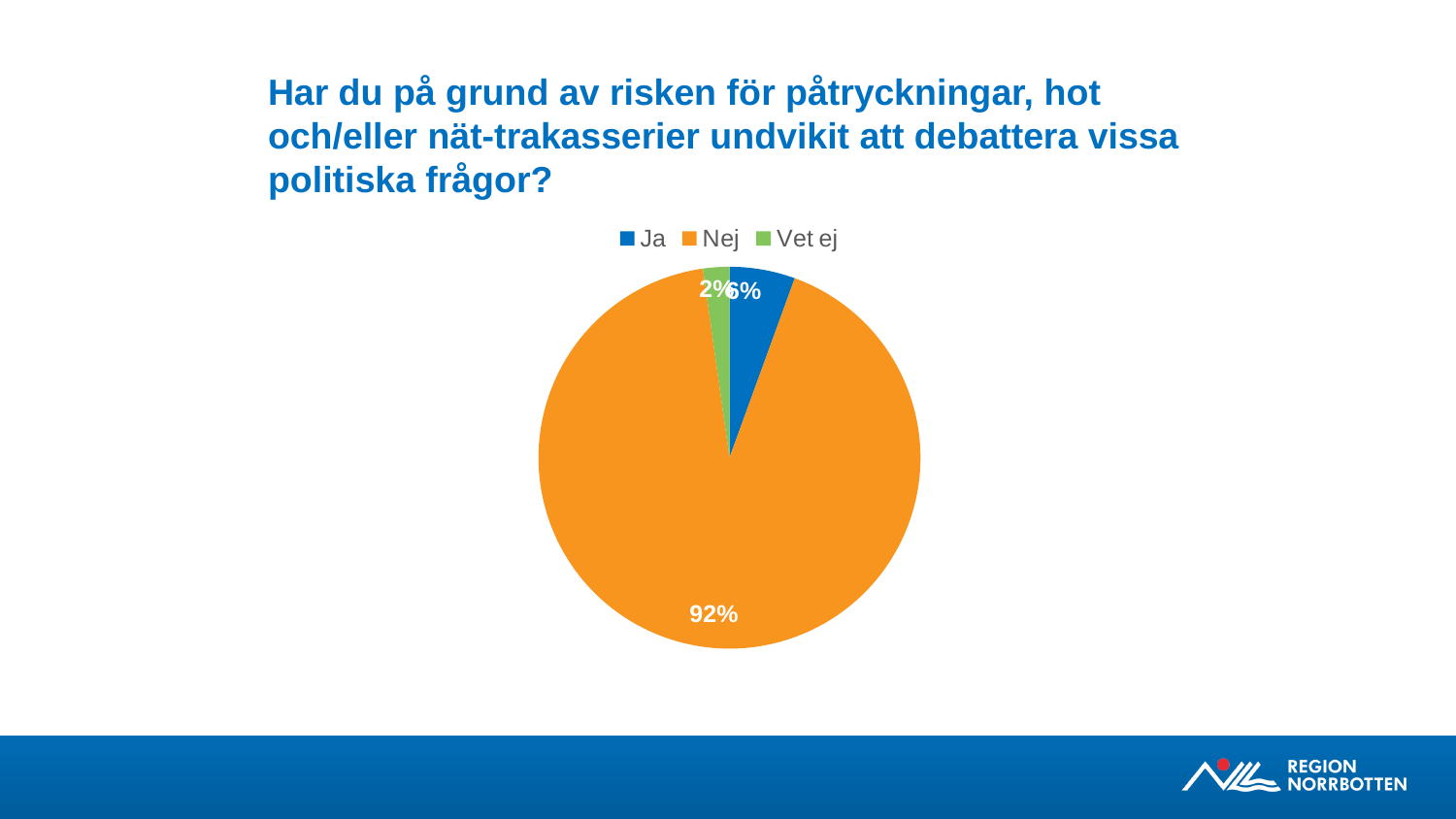
What is the difference in percentage points between "Nej" and "Ja"? 86 Which is larger, the share for "Ja" or the share for "Vet ej"? Ja What colour is the "Nej" slice? orange What share of the pie does "Vet ej" take? 2% Which legend entry is shown in green? Vet ej What kind of chart is shown on the slide? pie chart Which category has the smallest slice of the pie? Vet ej Which category has the largest slice of the pie? Nej How many categories does the pie chart show? 3 What share of the pie does "Ja" take? 6% How many entries does the legend list? 3 What share of the pie does "Nej" take? 92%